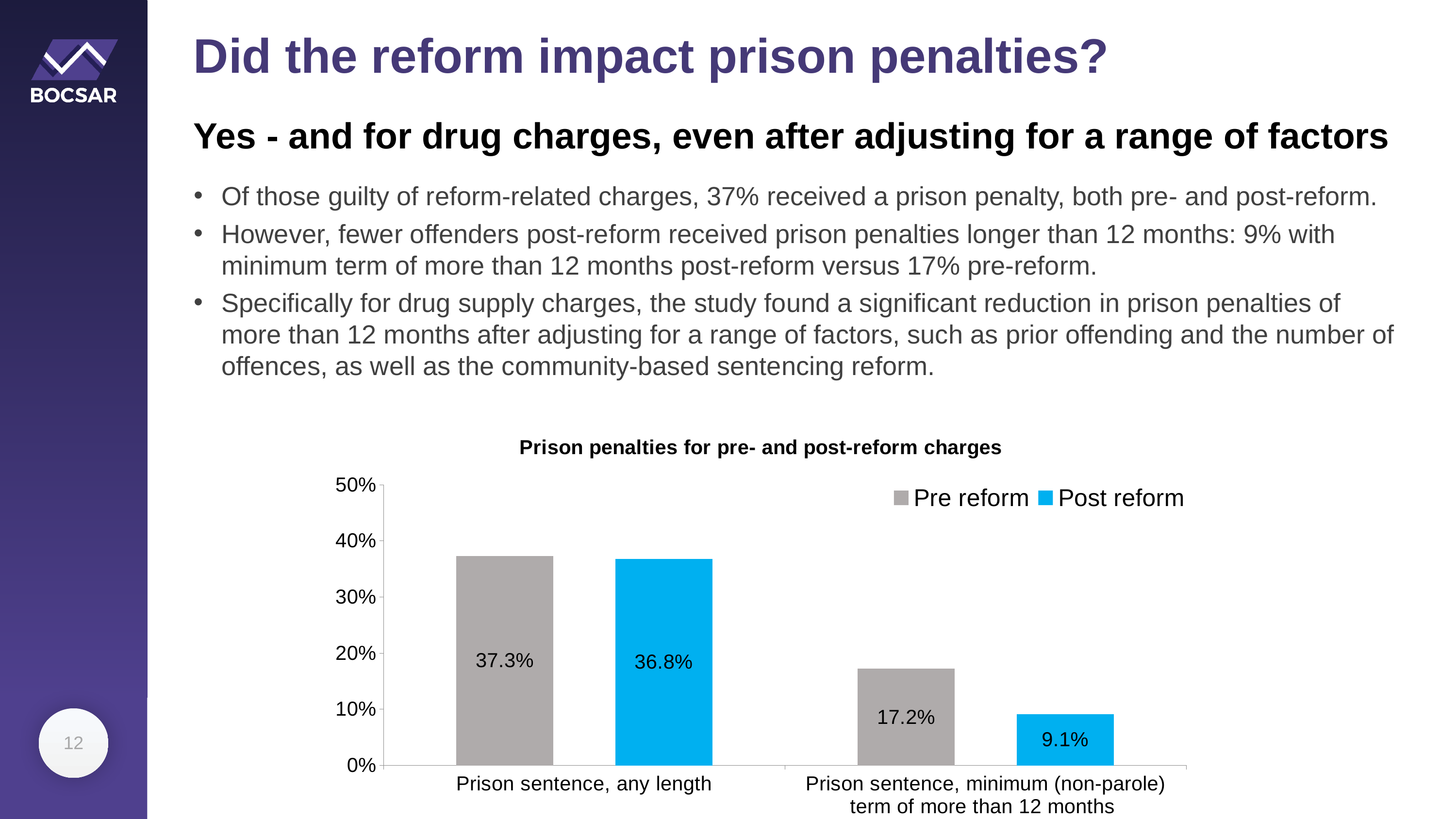
What is the Post reform value for 'Prison sentence, any length'? 36.8% How many categories are shown on the x axis? 2 Which bar in the chart has the lowest value? Post reform, Prison sentence, minimum (non-parole) term of more than 12 months How many series does the legend list? 2 What is the Pre reform value for 'Prison sentence, minimum (non-parole) term of more than 12 months'? 17.2% What is the Post reform value for 'Prison sentence, minimum (non-parole) term of more than 12 months'? 9.1% Which series has the larger value for 'Prison sentence, minimum (non-parole) term of more than 12 months', Pre reform or Post reform? Pre reform What is the difference between the Pre reform and Post reform values for 'Prison sentence, any length'? 0.5% What is the Pre reform value for 'Prison sentence, any length'? 37.3% What is the difference between the Pre reform and Post reform values for 'Prison sentence, minimum (non-parole) term of more than 12 months'? 8.1% What type of chart is shown on the slide? Bar chart Is the Post reform value for 'Prison sentence, minimum (non-parole) term of more than 12 months' greater or less than 10%? less